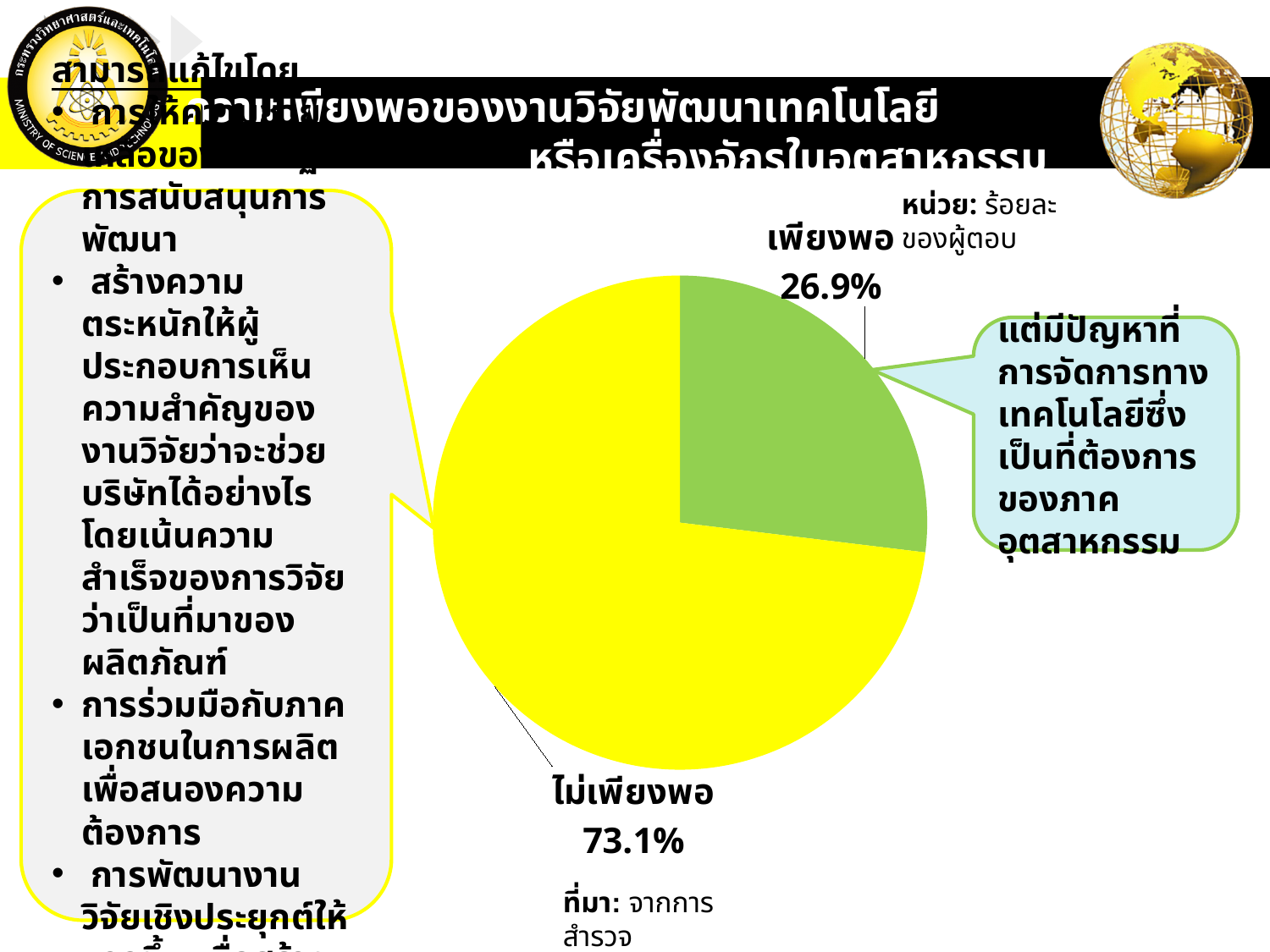
Which slice of the pie chart is the smallest? เพียงพอ How many slices does the pie chart have? 2 What is the difference in percentage points between ไม่เพียงพอ and เพียงพอ? 46.2 What is the total of the two slices in the pie chart? 100% What share of the pie does the เพียงพอ slice represent? 26.9% Which slice of the pie chart is the largest? ไม่เพียงพอ What percentage of respondents answered เพียงพอ? 26.9% Which is larger, the share for เพียงพอ or the share for ไม่เพียงพอ? ไม่เพียงพอ What colour is the ไม่เพียงพอ slice? yellow What percentage of respondents answered ไม่เพียงพอ? 73.1% What colour is the เพียงพอ slice? green What kind of chart is shown on the slide? pie chart